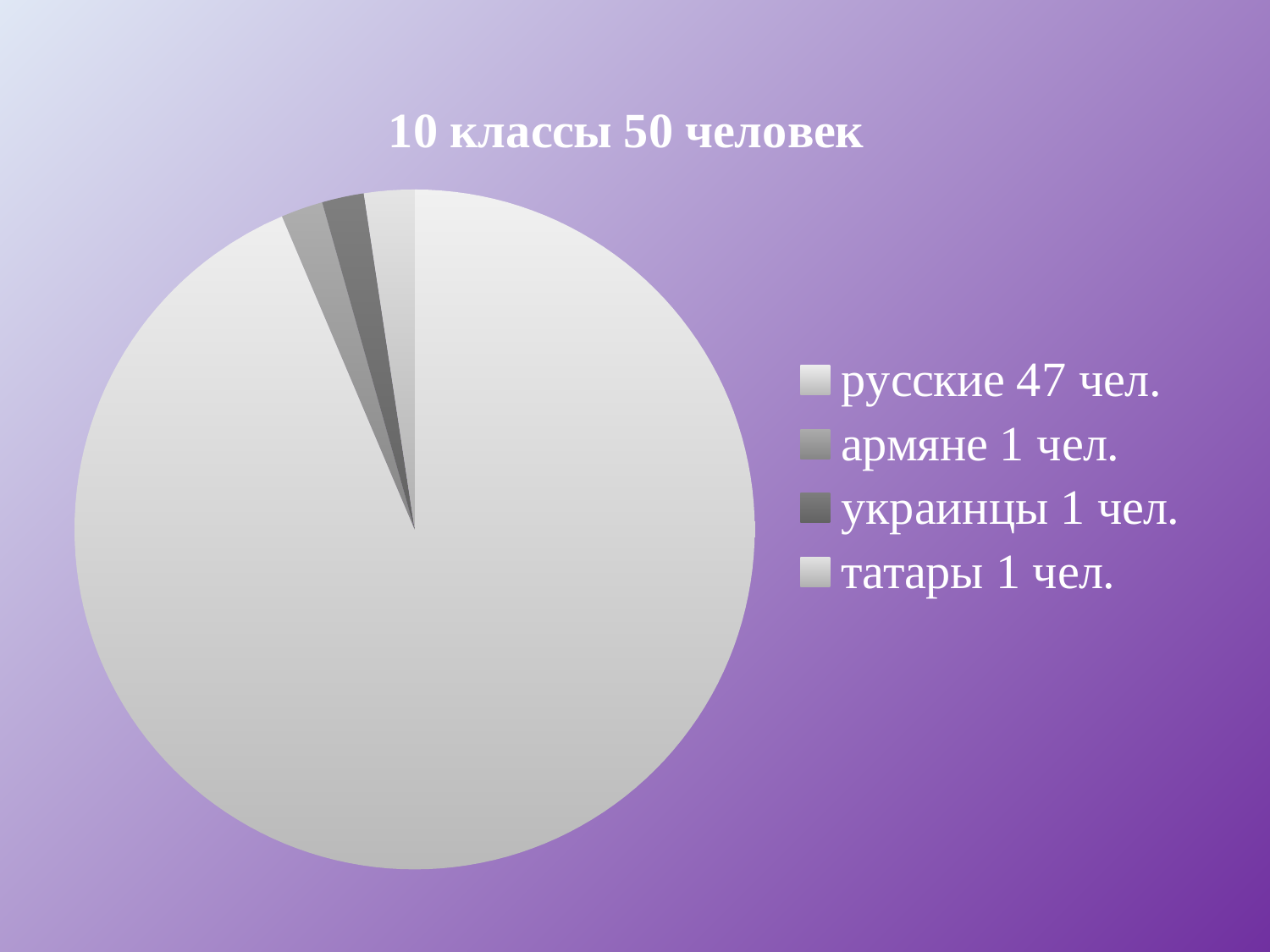
What kind of chart is shown on the slide? pie chart Which category has the largest slice of the pie? русские What is the difference between the number of русские and the number of татары? 46 What share of the pie does the русские slice represent? 94% How many people are in the украинцы category? 1 чел. Which is larger, the value for русские or the value for армяне? русские How many categories does the legend list? 4 How many people are in the татары category? 1 чел. What is the title of the chart? 10 классы 50 человек How many people are in the русские category? 47 чел. What is the total number of people across all slices of the pie? 50 How many people are in the армяне category? 1 чел.